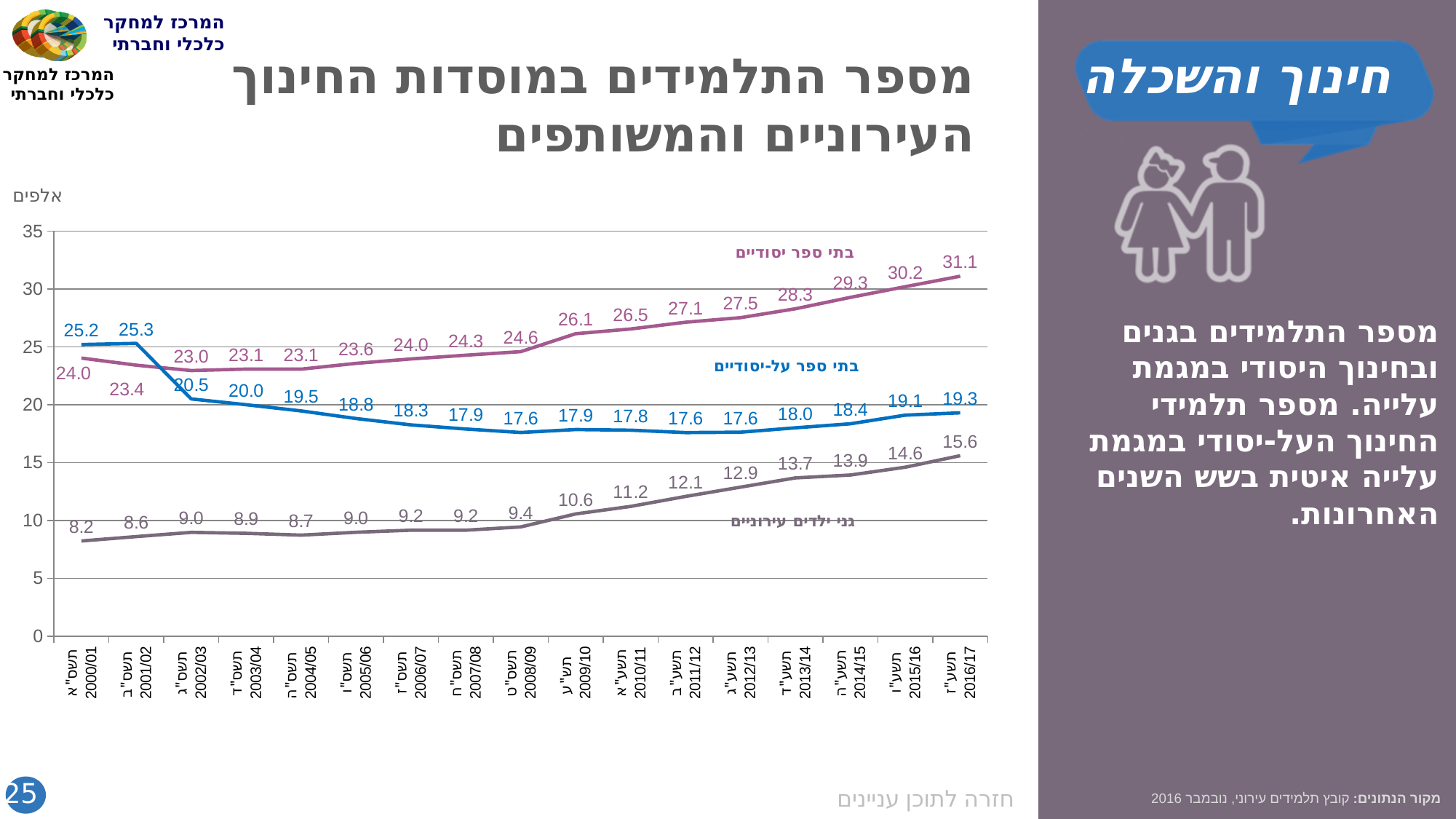
How many series (lines) are plotted on the chart? 3 What is the difference between the בתי ספר יסודיים value in 2016/17 and in 2000/01? 7.1 How many school years are shown along the x axis? 17 What is the value for גני ילדים עירוניים (municipal kindergartens) in 2008/09? 9.4 Which series has the higher value in 2000/01: בתי ספר יסודיים or בתי ספר על-יסודיים? בתי ספר על-יסודיים What unit label is shown above the y axis? אלפים What is the value for בתי ספר יסודיים (elementary schools) in 2016/17? 31.1 In which school year does the בתי ספר על-יסודיים (secondary schools) line reach its highest value? 2001/02 What type of chart is shown on the slide? line chart In which school year is the גני ילדים עירוניים (municipal kindergartens) value lowest? 2000/01 What is the value for בתי ספר על-יסודיים (secondary schools) in 2000/01? 25.2 Does the גני ילדים עירוניים (municipal kindergartens) line rise or fall from 2008/09 to 2016/17? rise